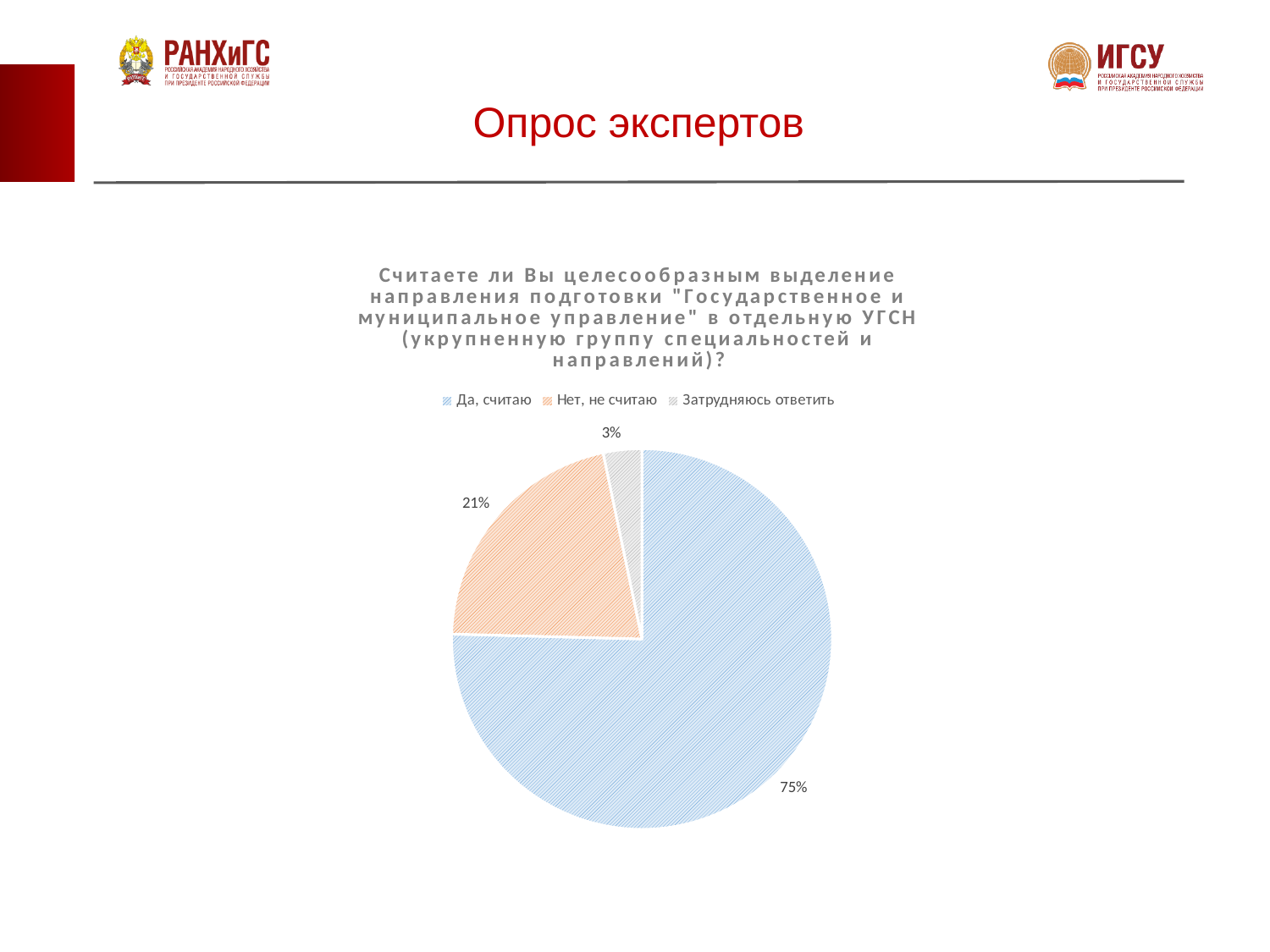
What share of the pie does "Нет, не считаю" have? 21% What is the difference in percentage points between "Да, считаю" and "Нет, не считаю"? 54 How many entries does the legend list? 3 What share of the pie does "Затрудняюсь ответить" have? 3% How many slices does the pie chart have? 3 Which response has the largest share of the pie? Да, считаю What share of the pie does "Да, считаю" have? 75% What is the title of the slide? Опрос экспертов What kind of chart is shown on the slide? pie chart Which is larger: the share for "Нет, не считаю" or the share for "Затрудняюсь ответить"? Нет, не считаю Which response has the smallest share of the pie? Затрудняюсь ответить What is the difference in percentage points between "Нет, не считаю" and "Затрудняюсь ответить"? 18